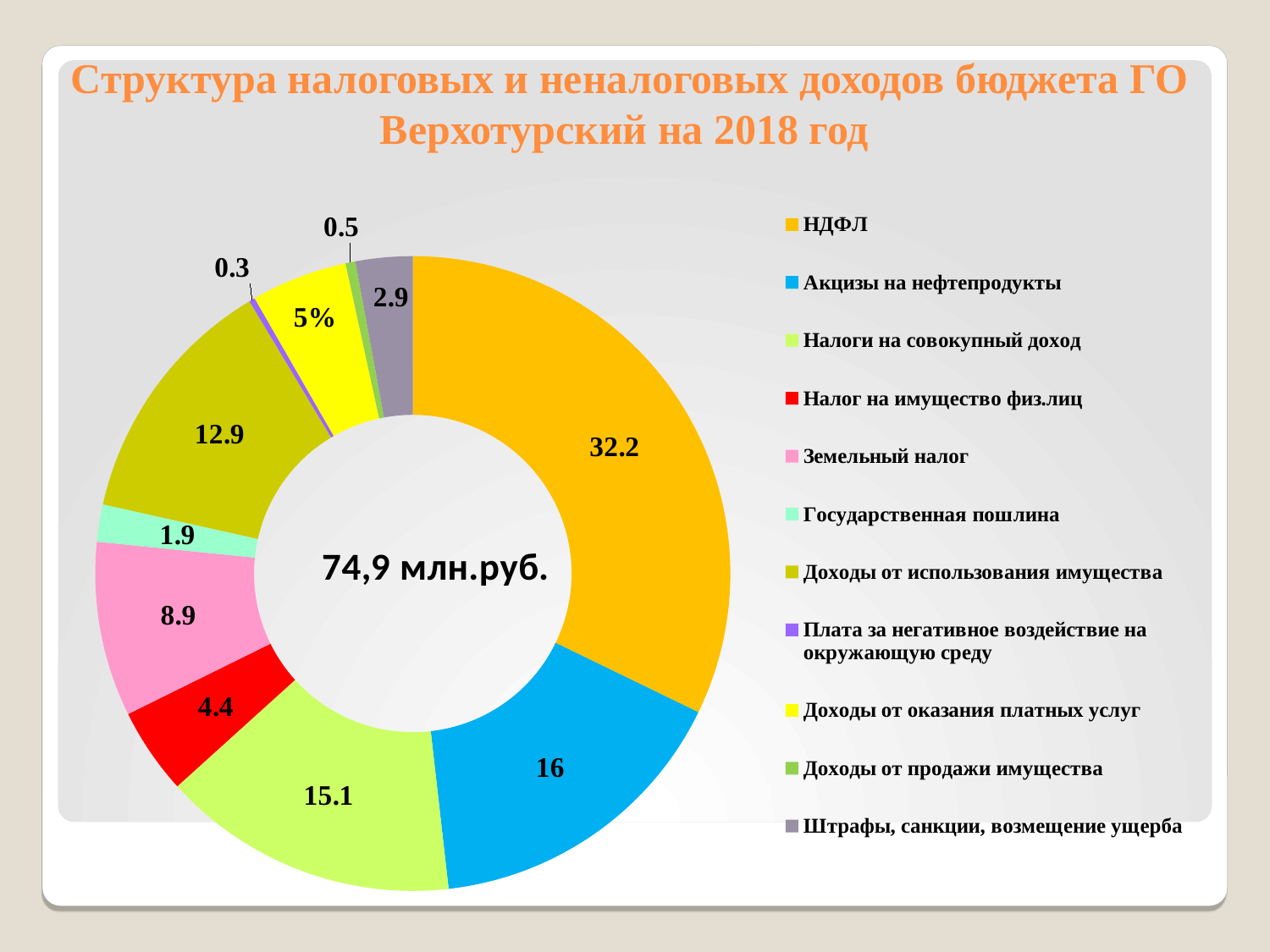
Which is larger: the value for Налоги на совокупный доход or the value for Доходы от использования имущества? Налоги на совокупный доход What is the difference between the values for НДФЛ and Акцизы на нефтепродукты? 16.2 What is the value shown for Земельный налог? 8.9 What is the value shown for Плата за негативное воздействие на окружающую среду? 0.3 What type of chart is shown on the slide? Doughnut (pie) chart How many categories does the legend list? 11 Which category has the smallest slice of the chart? Плата за негативное воздействие на окружающую среду What is the value shown for Акцизы на нефтепродукты? 16 What is the value shown for НДФЛ? 32.2 Which category has the largest slice of the chart? НДФЛ What total amount is written in the centre of the chart? 74,9 млн.руб. What is the value shown for Доходы от использования имущества? 12.9